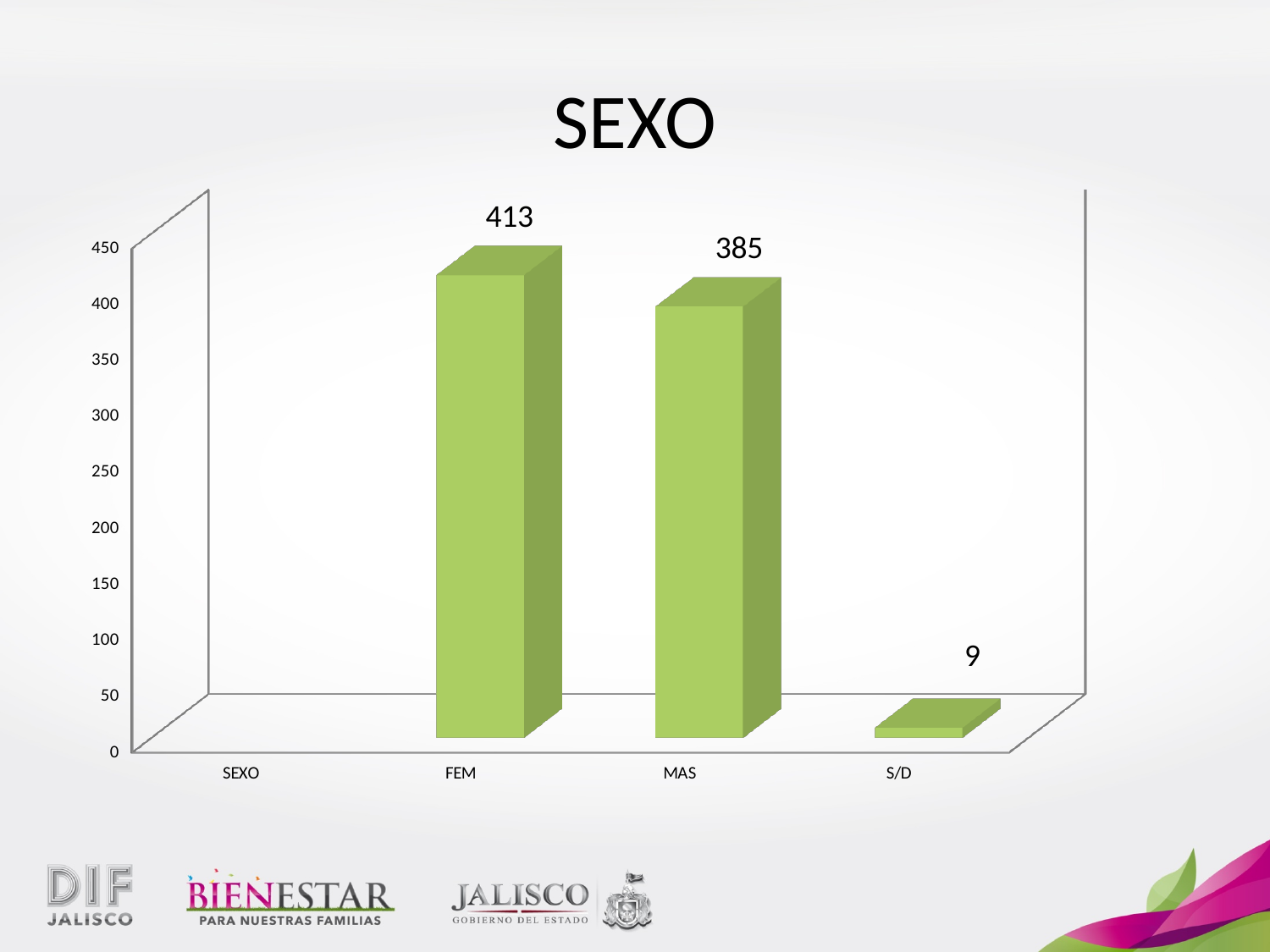
What is the value for FEM? 413 How many categories are shown on the x axis? 4 Which category has the lowest value? S/D What is the difference between the values for FEM and MAS? 28 What is the difference between the values for MAS and S/D? 376 What is the value for MAS? 385 Is the value for MAS greater or less than 400? less What is the title of the chart? SEXO What kind of chart is shown on the slide? bar chart Which category has the highest value? FEM Which is larger, the value for FEM or the value for MAS? FEM What is the value for S/D? 9